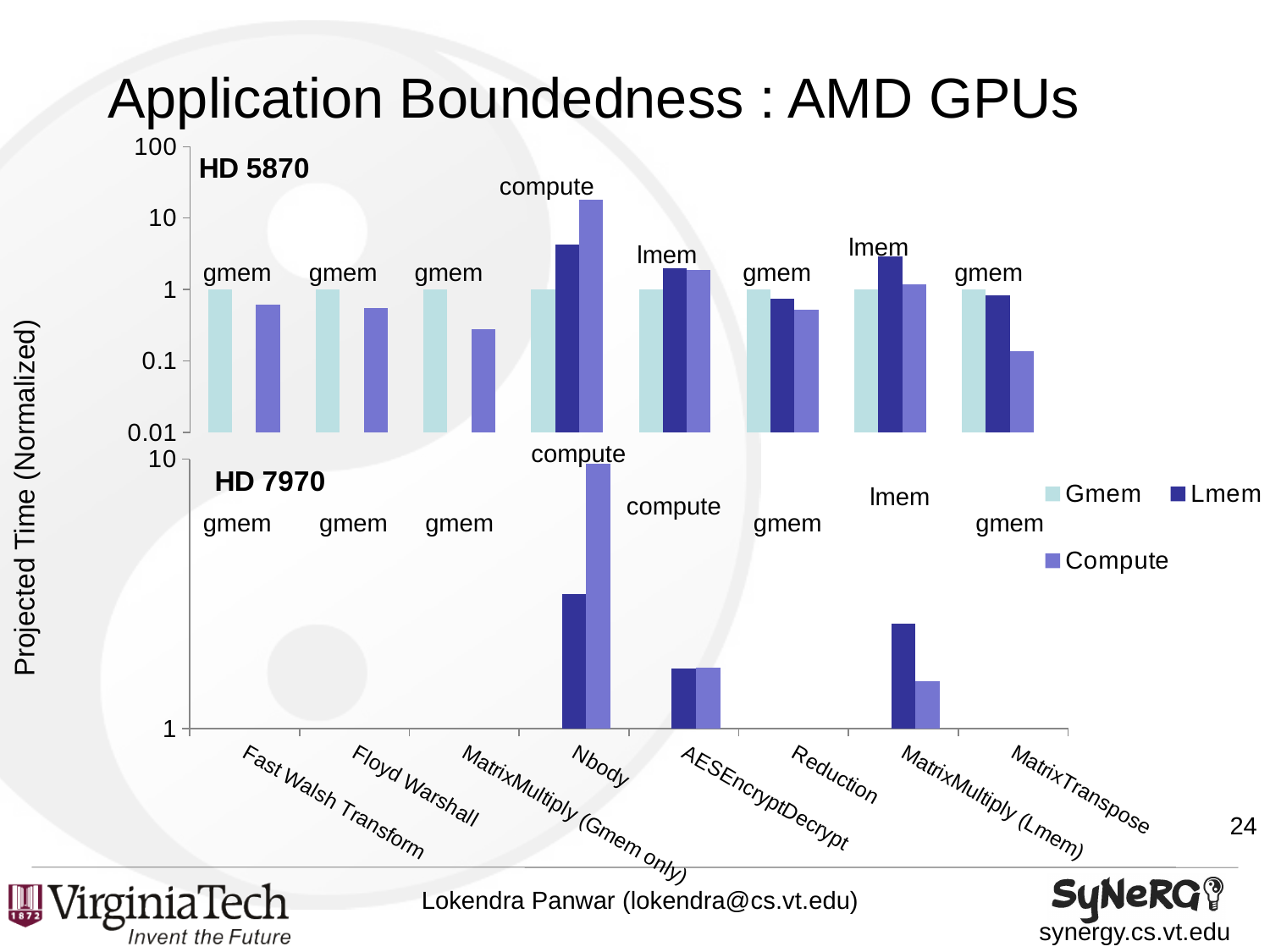
In the HD 7970 chart, which application has the highest bar? Nbody How many application categories are shown along the x axis? 8 In the HD 7970 chart, for MatrixMultiply (Lmem), which is larger: the Lmem bar or the Compute bar? Lmem In the HD 5870 chart, which application has the highest bar? Nbody What are the three series named in the legend? Gmem, Lmem, Compute In the HD 5870 chart, is the Compute value for Floyd Warshall greater or less than 1? less In the HD 5870 chart, what is the Gmem value for Fast Walsh Transform? 1 In the HD 5870 chart, is the Compute value for Nbody greater or less than 10? greater How many charts are on the slide, and what kind of chart are they? Two bar charts In the HD 5870 chart, for Reduction, which is larger: the Lmem bar or the Compute bar? Lmem In the HD 7970 chart, what boundedness label is written above the Nbody bars? compute How many series does the legend list? 3